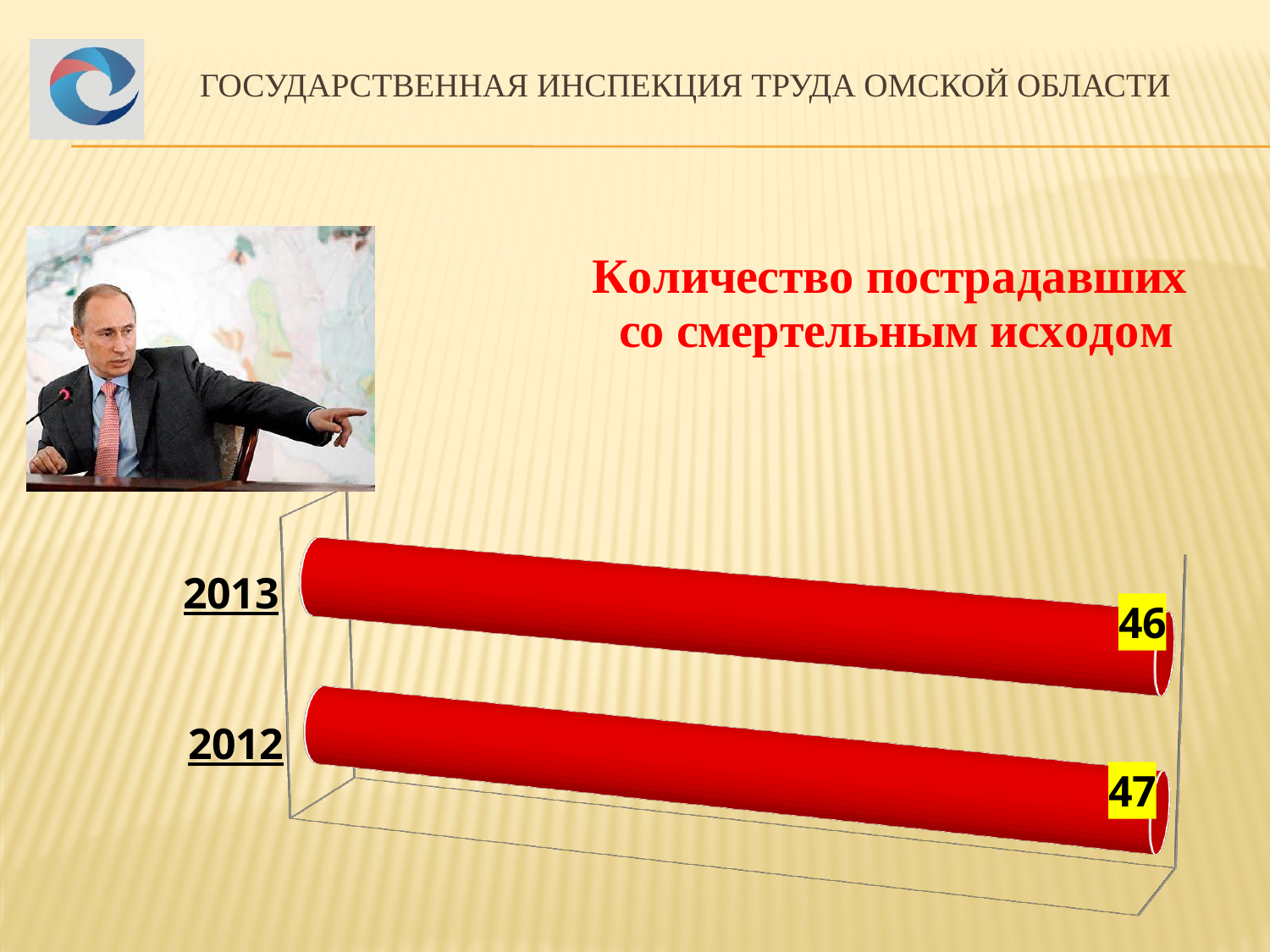
What is the difference between the values for 2012 and 2013? 1 What kind of chart is shown on the slide? bar chart What is the title of the chart? Количество пострадавших со смертельным исходом What colour are the bars in the chart? red What is the value for 2012? 47 Which year has the lower value? 2013 What is the value for 2013? 46 Did the number of fatalities rise or fall from 2012 to 2013? fall Is the value for 2013 larger or smaller than the value for 2012? smaller Which year has the higher value? 2012 How many categories (years) are shown in the chart? 2